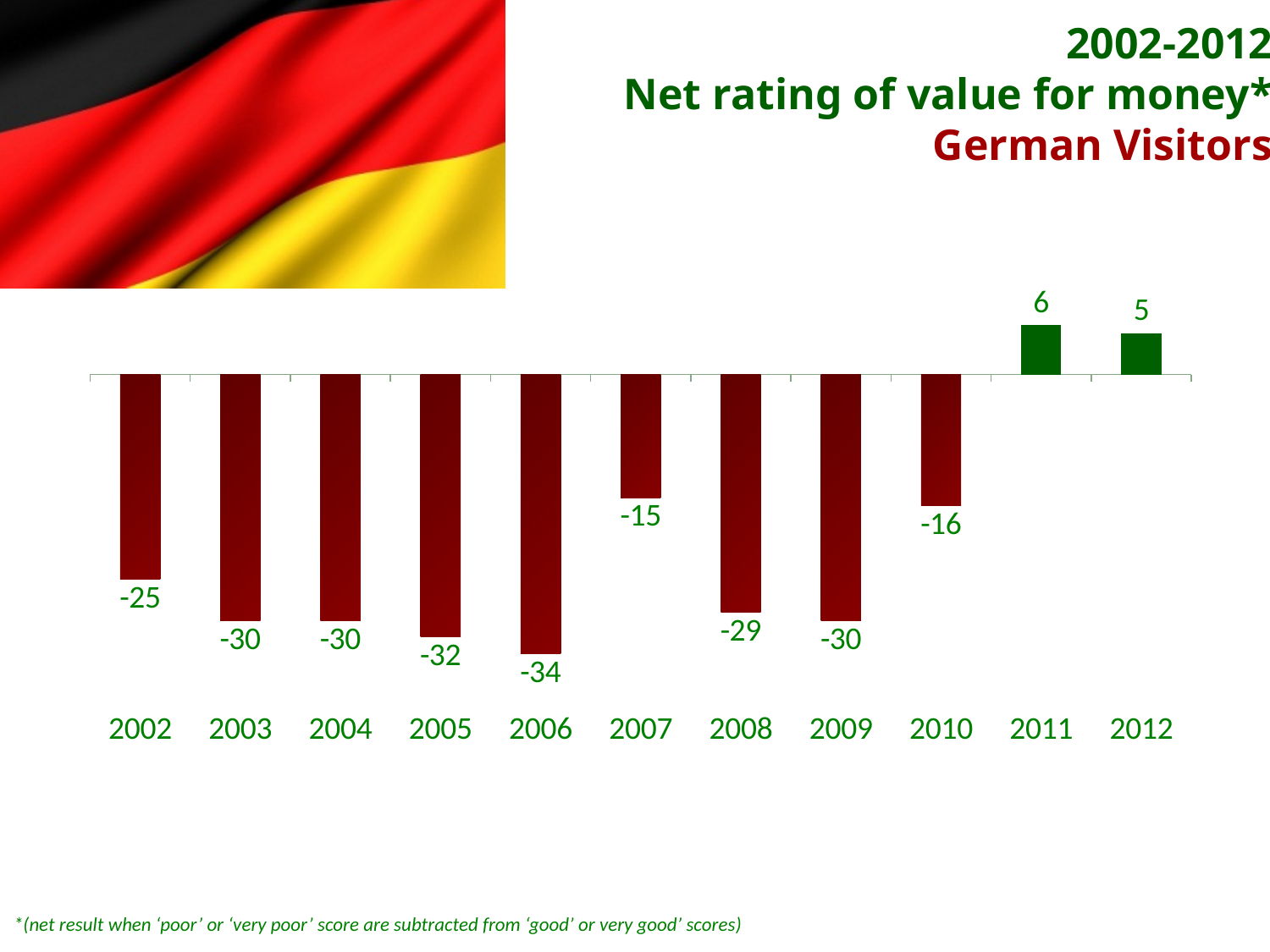
What colour are the bars for years with a positive net rating? Green What kind of chart is shown on the slide? Bar chart How many years on the chart have a positive net rating? 2 What is the net rating of value for money for German visitors in 2010? -16 What is the net rating of value for money for German visitors in 2002? -25 What is the difference between the net rating in 2012 and the net rating in 2010? 21 Which year has the highest net rating of value for money? 2011 What is the net rating of value for money for German visitors in 2011? 6 How many years are shown on the chart? 11 Which year has the lowest net rating of value for money? 2006 What is the net rating of value for money for German visitors in 2006? -34 Which year has a higher net rating, 2007 or 2008? 2007